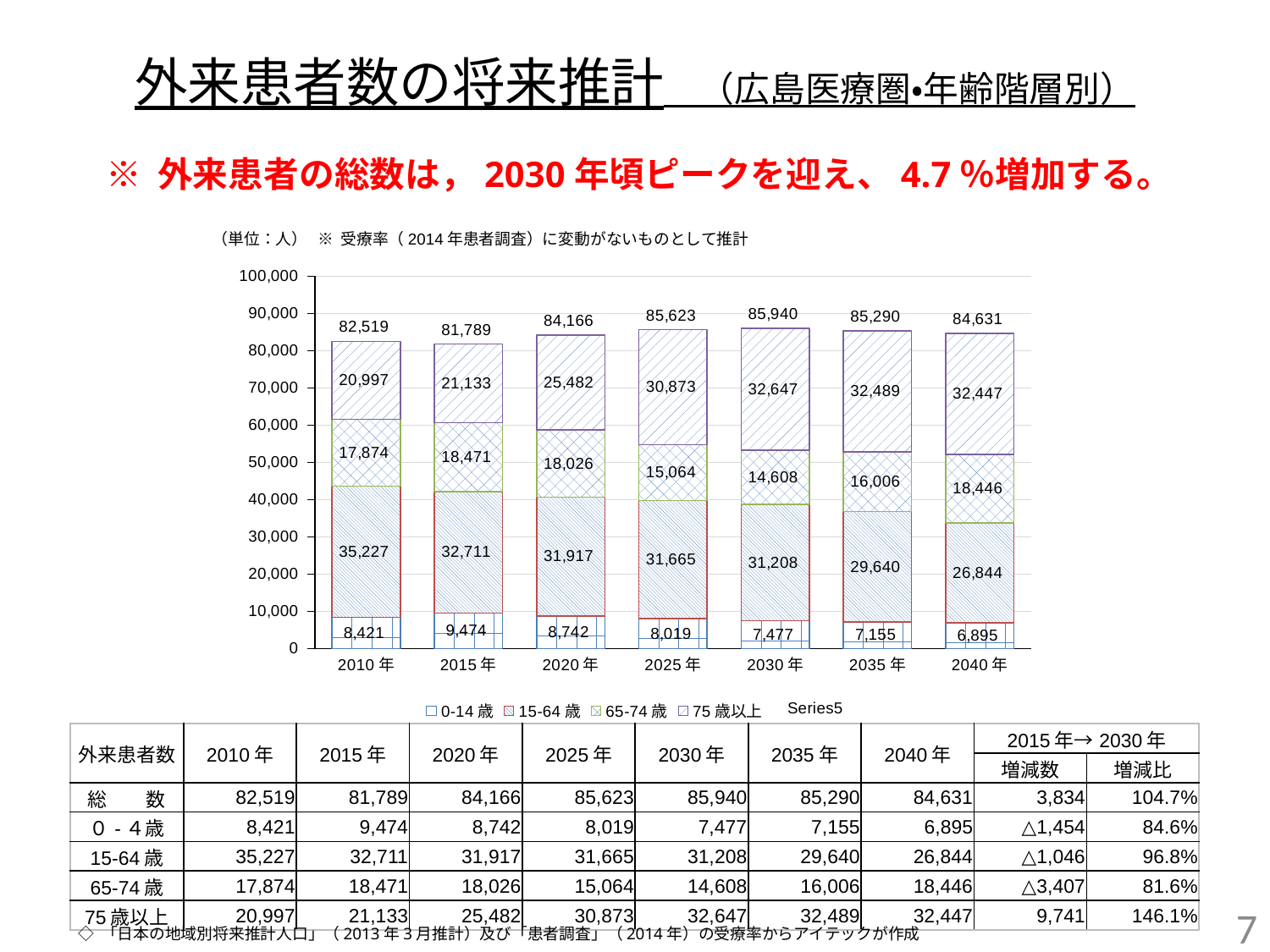
What type of chart is shown on the slide? stacked bar chart Which is larger, the 65-74歳 value in 2025年 or in 2035年? 2035年 Does the 75歳以上 segment rise or fall from 2010年 to 2030年? rise What is the total number of outpatients shown above the bar for 2030年? 85,940 What is the difference between the 75歳以上 values for 2040年 and 2010年? 11,450 How many entries does the chart legend list? 5 How many years (categories) are plotted along the x axis of the chart? 7 What is the value for the 0-14歳 segment in 2015年? 9,474 Which year has the lowest total number of outpatients? 2015年 What is the value for the 75歳以上 segment in 2040年? 32,447 Which year has the highest total number of outpatients? 2030年 What is the value for the 15-64歳 segment in 2010年? 35,227